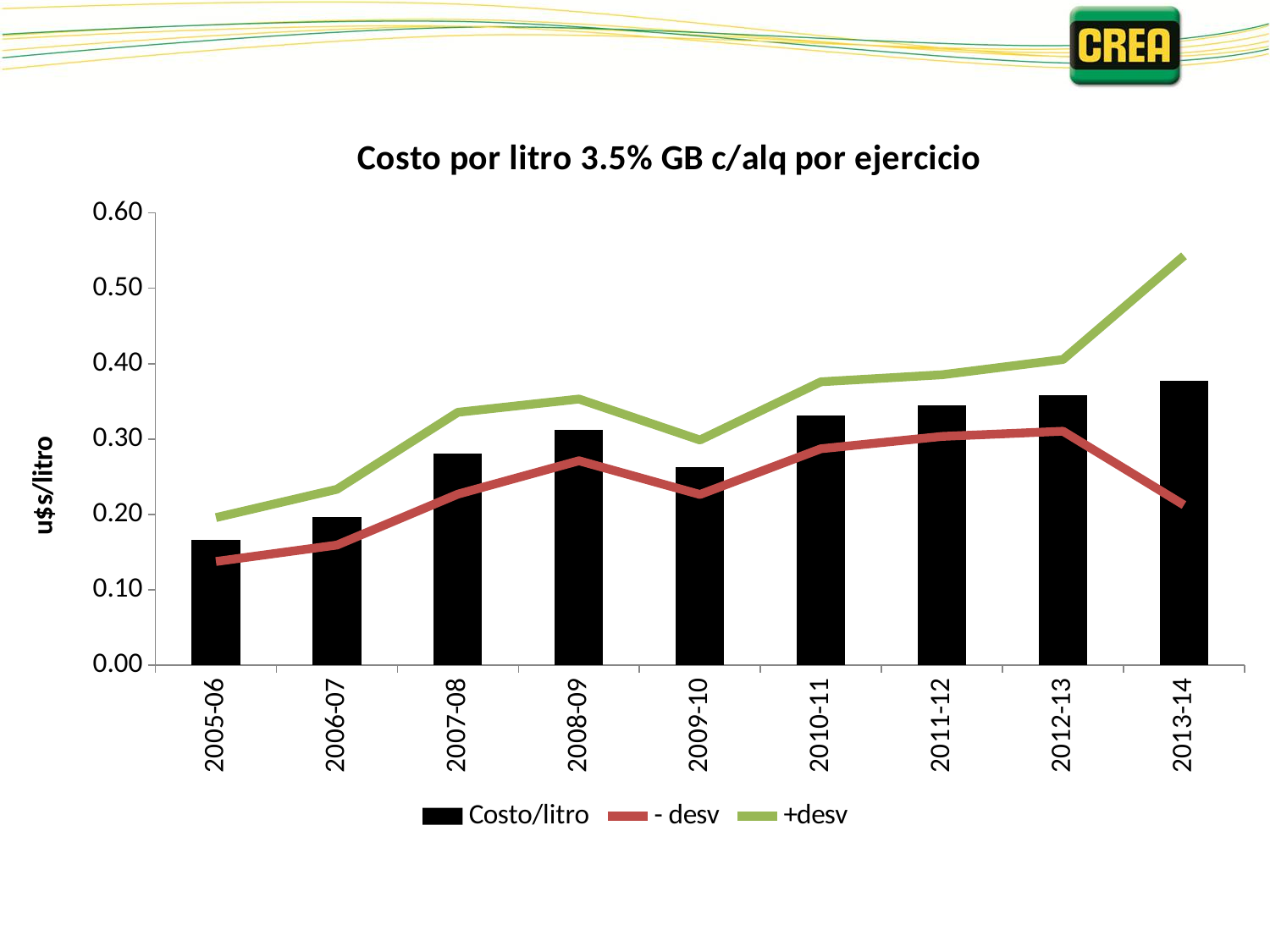
What kind of chart is shown on the slide? A combined bar and line chart Is the +desv value for 2013-14 greater or less than 0.50? greater Which ejercicio has the highest Costo/litro bar? 2013-14 How many series does the legend list? 3 Is the Costo/litro value for 2009-10 greater or less than 0.30? less How many ejercicios (periods) are shown on the x axis? 9 Is the Costo/litro value for 2005-06 greater or less than 0.20? less Which ejercicio has the lowest Costo/litro bar? 2005-06 Does the Costo/litro series rise or fall from 2009-10 to 2013-14? Rise What is the label on the vertical axis? u$s/litro Which is larger, the Costo/litro bar for 2008-09 or for 2009-10? 2008-09